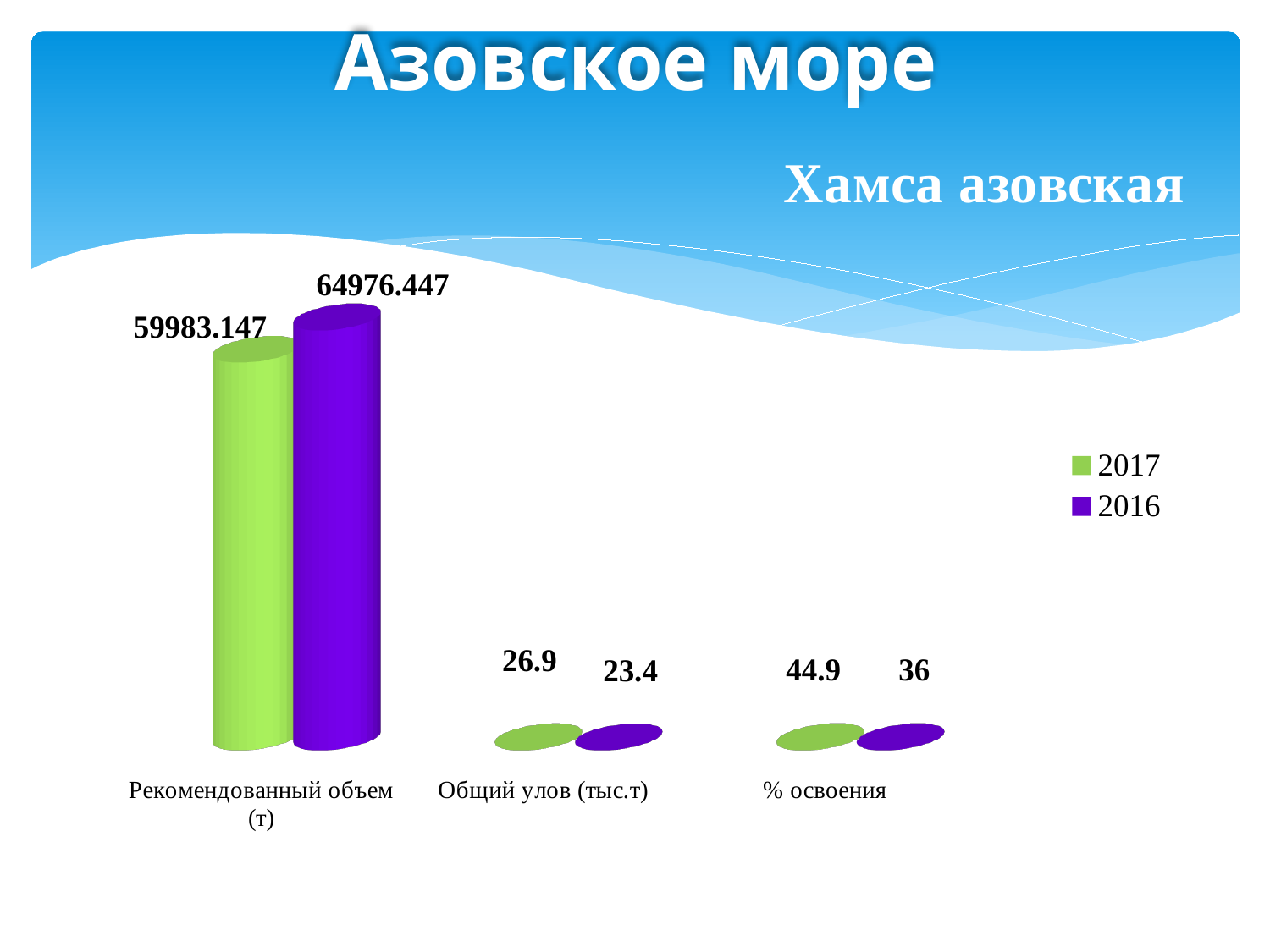
What is the value for 2016 in the category "Рекомендованный объем (т)"? 64976.447 What is the value for 2017 in the category "Рекомендованный объем (т)"? 59983.147 Which year has the higher value for "% освоения"? 2017 What kind of chart is shown on the slide? Bar chart What is the value for 2016 in the category "% освоения"? 36 Which colour represents the 2016 series in the chart? Purple What is the difference between the 2017 and 2016 values for "Общий улов (тыс.т)"? 3.5 Which year has the higher value for "Рекомендованный объем (т)"? 2016 How many series does the legend list? 2 How many categories are shown on the x axis of the chart? 3 What is the value for 2017 in the category "Общий улов (тыс.т)"? 26.9 What is the difference between the 2017 and 2016 values for "% освоения"? 8.9